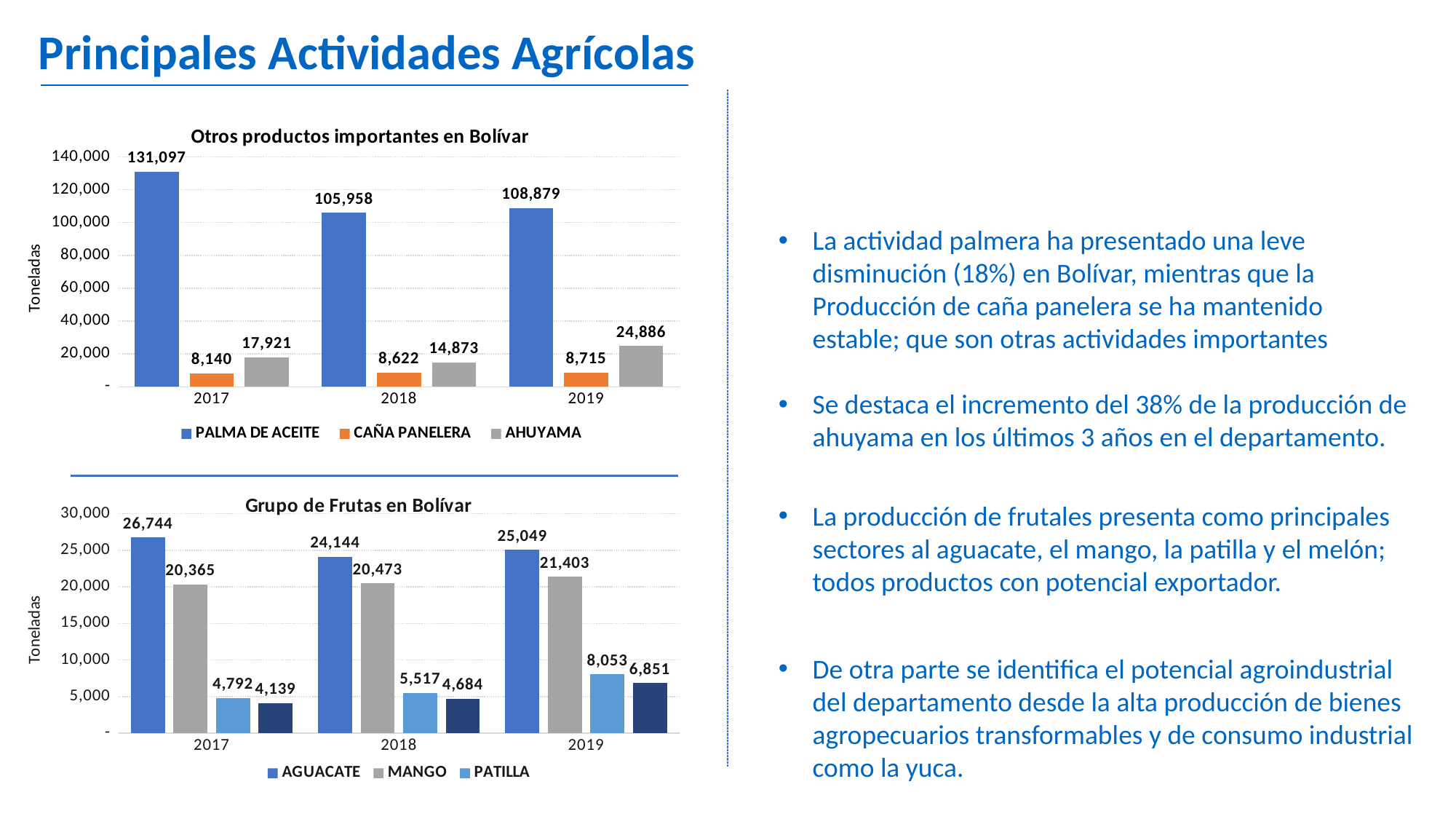
In the chart 'Otros productos importantes en Bolívar', what is the difference between the AHUYAMA values for 2019 and 2017? 6,965 In the chart 'Otros productos importantes en Bolívar', which year had the highest value for PALMA DE ACEITE? 2017 In the chart 'Otros productos importantes en Bolívar', what was the value for AHUYAMA in 2019? 24,886 What kind of chart is 'Grupo de Frutas en Bolívar'? bar chart In the chart 'Grupo de Frutas en Bolívar', what was the value for PATILLA in 2018? 5,517 In the chart 'Grupo de Frutas en Bolívar', what was the value for AGUACATE in 2019? 25,049 In the chart 'Grupo de Frutas en Bolívar', which year had the lowest value for MANGO? 2017 In the chart 'Grupo de Frutas en Bolívar', which is larger in 2019: AGUACATE or MANGO? AGUACATE In the chart 'Otros productos importantes en Bolívar', what was the value for PALMA DE ACEITE in 2017? 131,097 In the chart 'Grupo de Frutas en Bolívar', what is the difference between AGUACATE and MANGO in 2018? 3,671 In the chart 'Otros productos importantes en Bolívar', how many series does the legend list? 3 In the chart 'Otros productos importantes en Bolívar', did the value for CAÑA PANELERA rise or fall from 2017 to 2019? rise